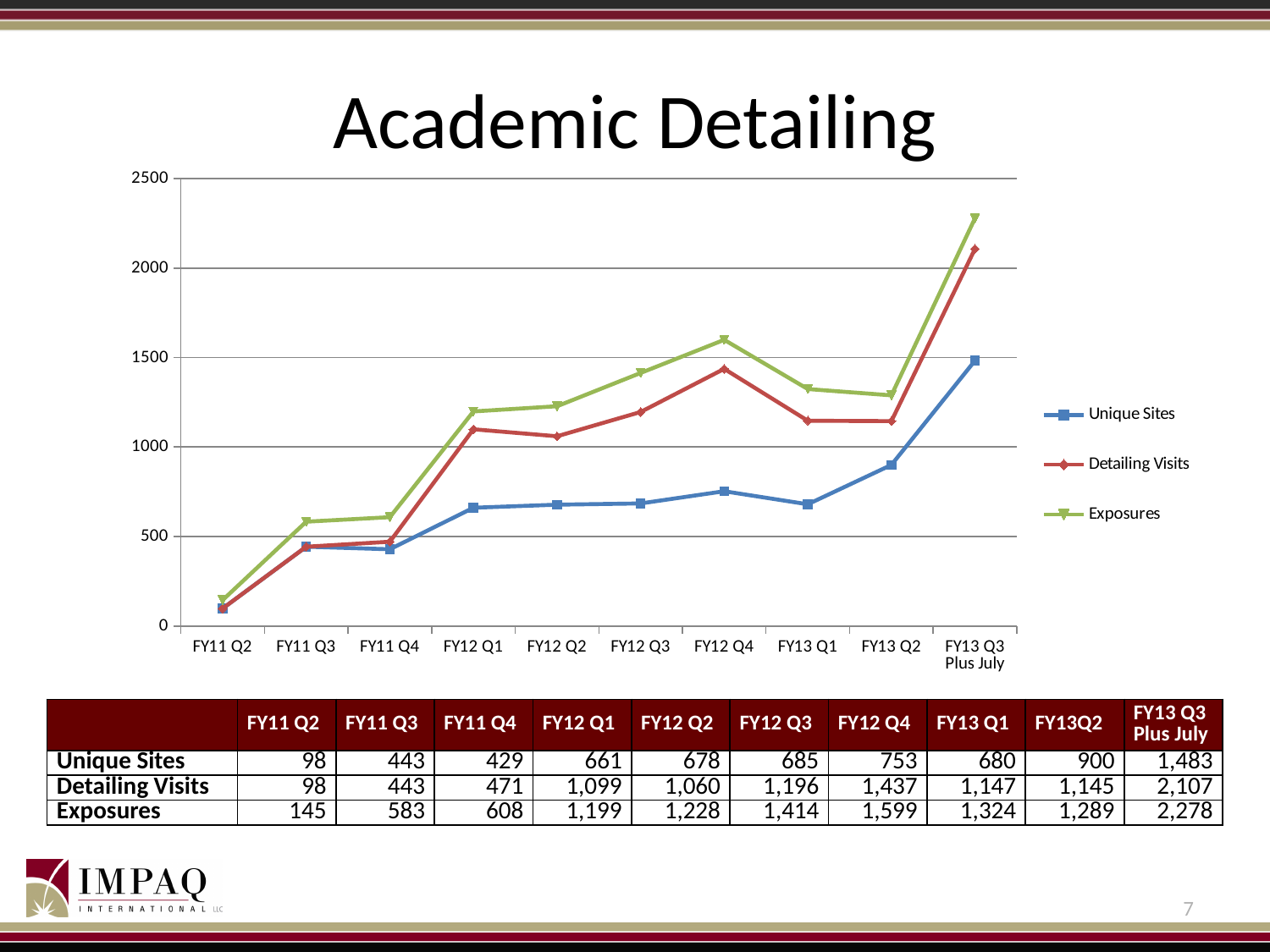
What is the difference between Exposures and Detailing Visits in FY13 Q3 Plus July? 171 What is the value of Unique Sites for FY13 Q2? 900 Is the value of Detailing Visits for FY13 Q1 greater or less than 1000? greater What is the value of Detailing Visits for FY12 Q1? 1,099 In which period is Unique Sites lowest? FY11 Q2 How many periods are plotted along the x axis? 10 What kind of chart is shown on the slide? line chart What is the title of the chart? Academic Detailing Which is larger in FY11 Q4: Unique Sites or Detailing Visits? Detailing Visits What is the value of Exposures for FY12 Q4? 1,599 In which period is Exposures highest? FY13 Q3 Plus July How many series does the legend list? 3